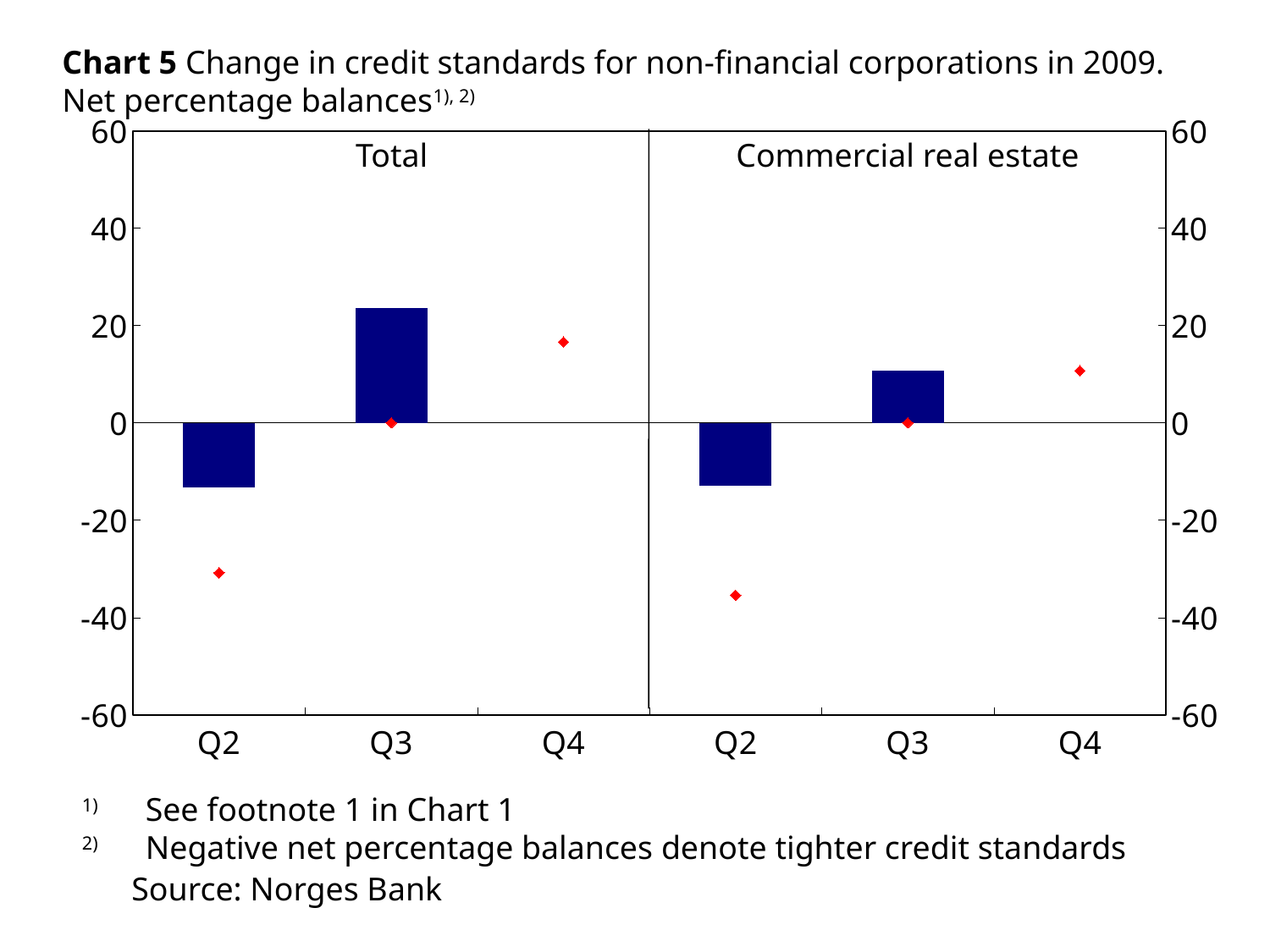
In the Total panel, which quarter has the highest bar? Q3 Which Q3 bar is larger: the one in the Total panel or the one in the Commercial real estate panel? Total In the Commercial real estate panel, is the bar for Q3 greater or less than 20? less In the Total panel, is the bar for Q2 greater or less than 0? less In the Total panel, is the bar for Q3 greater or less than 20? greater What kind of chart is shown on the slide? combination bar and line chart (bars with red diamond markers) What are the titles of the two panels of the chart? Total and Commercial real estate In the Total panel, do the bars rise or fall from Q2 to Q3? rise What is the highest value shown on the vertical axis? 60 How many quarters are labelled on the x axis of each panel? 3